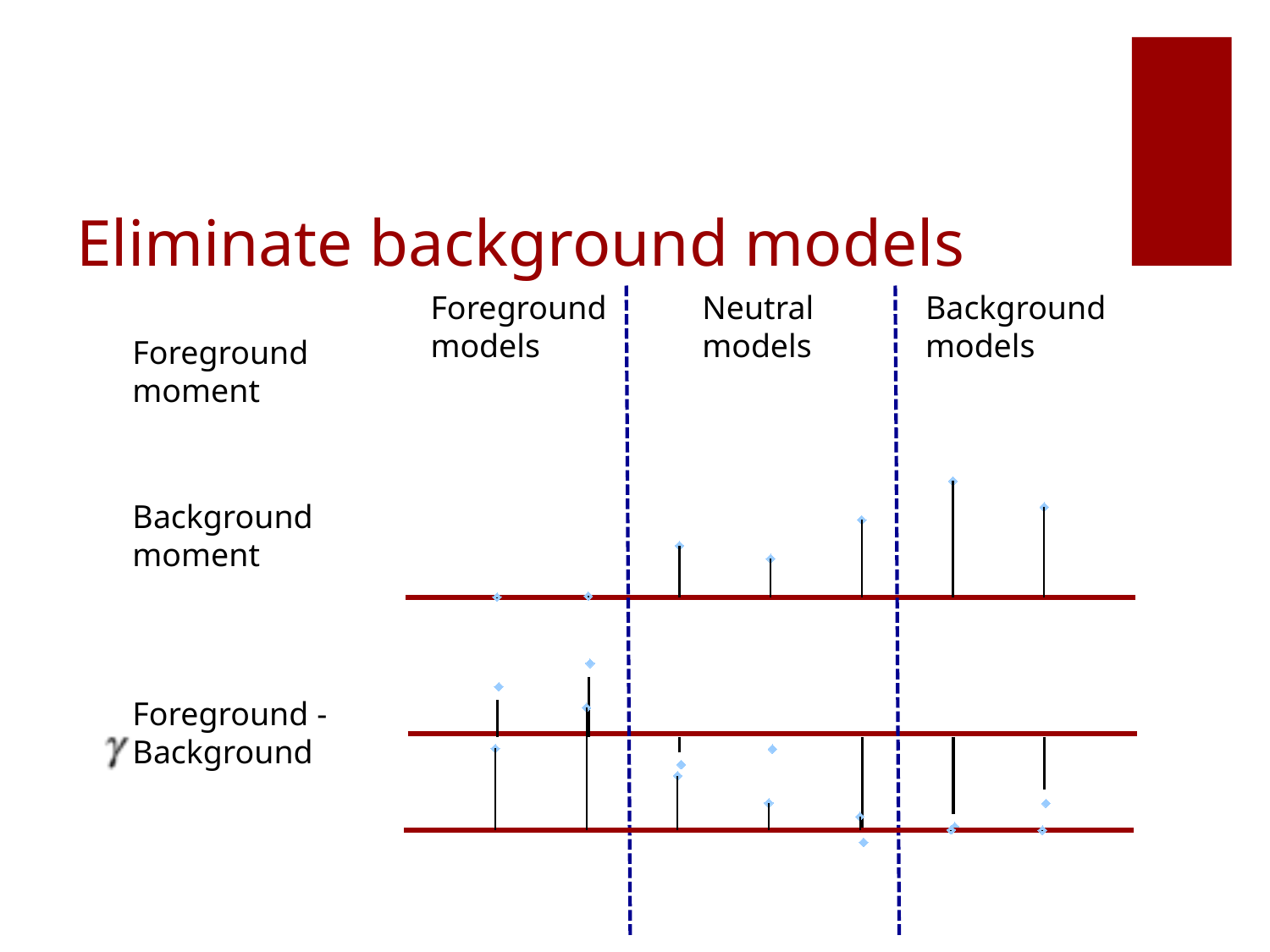
In the Background moment plot, which model group has the tallest stems? Background models What is the title of the slide containing the charts? Eliminate background models In the Foreground - Background plot, are the values for the Foreground models group above or below the upper red line? above In the Foreground - Background plot, are the values for the Background models group above or below the upper red line? below In the Background moment plot, how many stems are in the Neutral models group? 3 What are the three model groups labeled along the top of the diagram? Foreground models, Neutral models, Background models In the Background moment plot, how many stems are in the Background models group? 2 In the Background moment plot, how many stems (points) are drawn in total? 7 What label appears to the left of the Foreground - Background plot? Foreground - Background In the Background moment plot, which model group has its points lying on the baseline (zero)? Foreground models